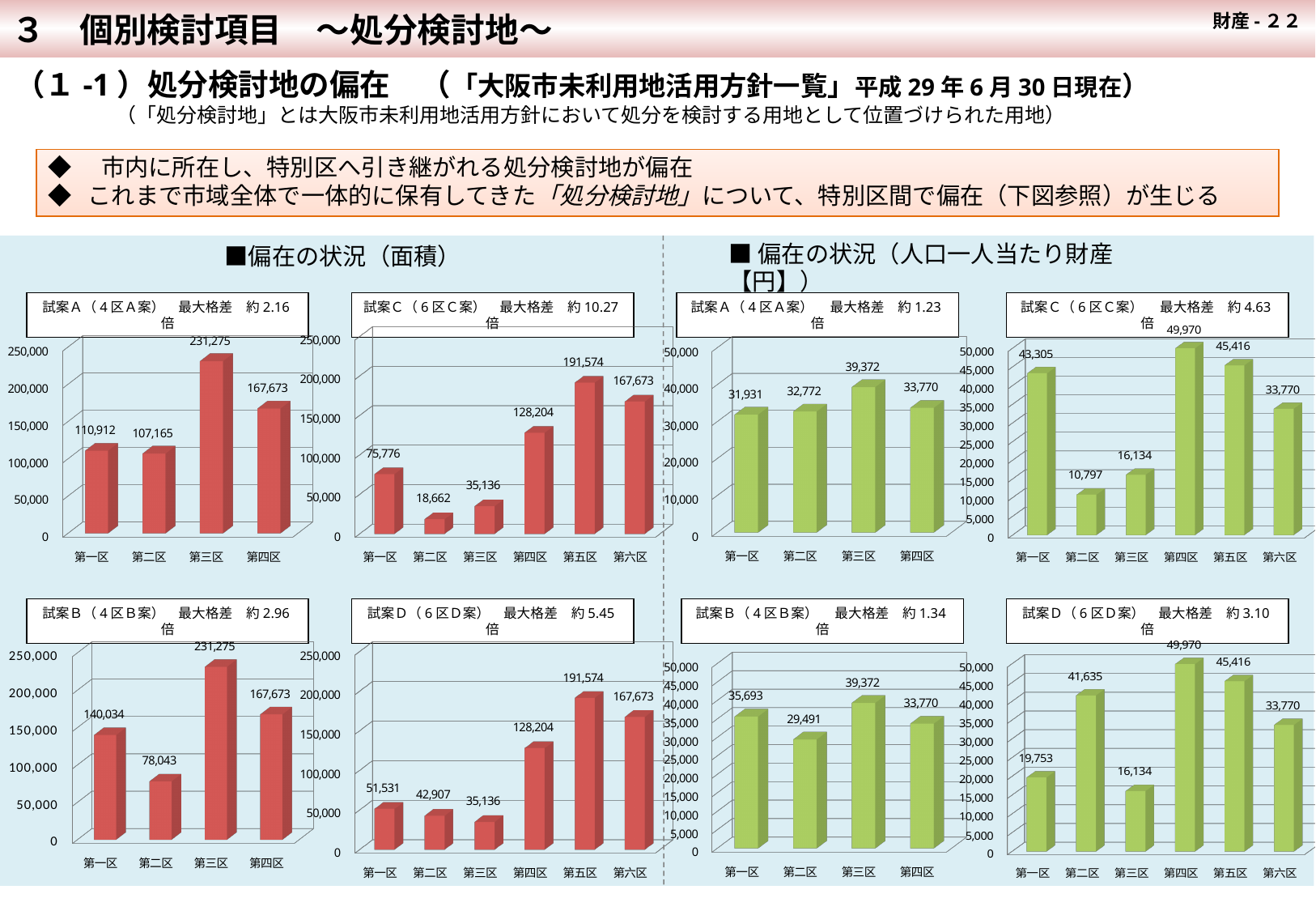
In the 偏在の状況（人口一人当たり財産） 試案A（4区A案） chart, which district has the highest value? 第三区 In the 偏在の状況（面積） 試案D（6区D案） chart, which is larger, 第一区 or 第三区? 第一区 In the 偏在の状況（面積） 試案B（4区B案） chart, what is the value for 第二区? 78,043 In the 偏在の状況（人口一人当たり財産） 試案D（6区D案） chart, what is the value for 第一区? 19,753 In the 偏在の状況（人口一人当たり財産） 試案B（4区B案） chart, what is the difference between 第一区 and 第二区? 6,202 What type of chart is used for the 偏在の状況（面積） 試案A（4区A案） data? bar chart In the 偏在の状況（面積） 試案C（6区C案） chart, what is the difference between 第五区 and 第二区? 172,912 In the 偏在の状況（面積） 試案C（6区C案） chart, which district has the lowest value? 第二区 In the 偏在の状況（面積） 試案D（6区D案） chart, how many districts are plotted? 6 In the 偏在の状況（人口一人当たり財産） 試案C（6区C案） chart, what is the value for 第二区? 10,797 In the 偏在の状況（面積） 試案A（4区A案） chart, what is the value for 第三区? 231,275 What 最大格差 (maximum disparity) is stated in the title of the 偏在の状況（面積） 試案C（6区C案） chart? 約10.27倍